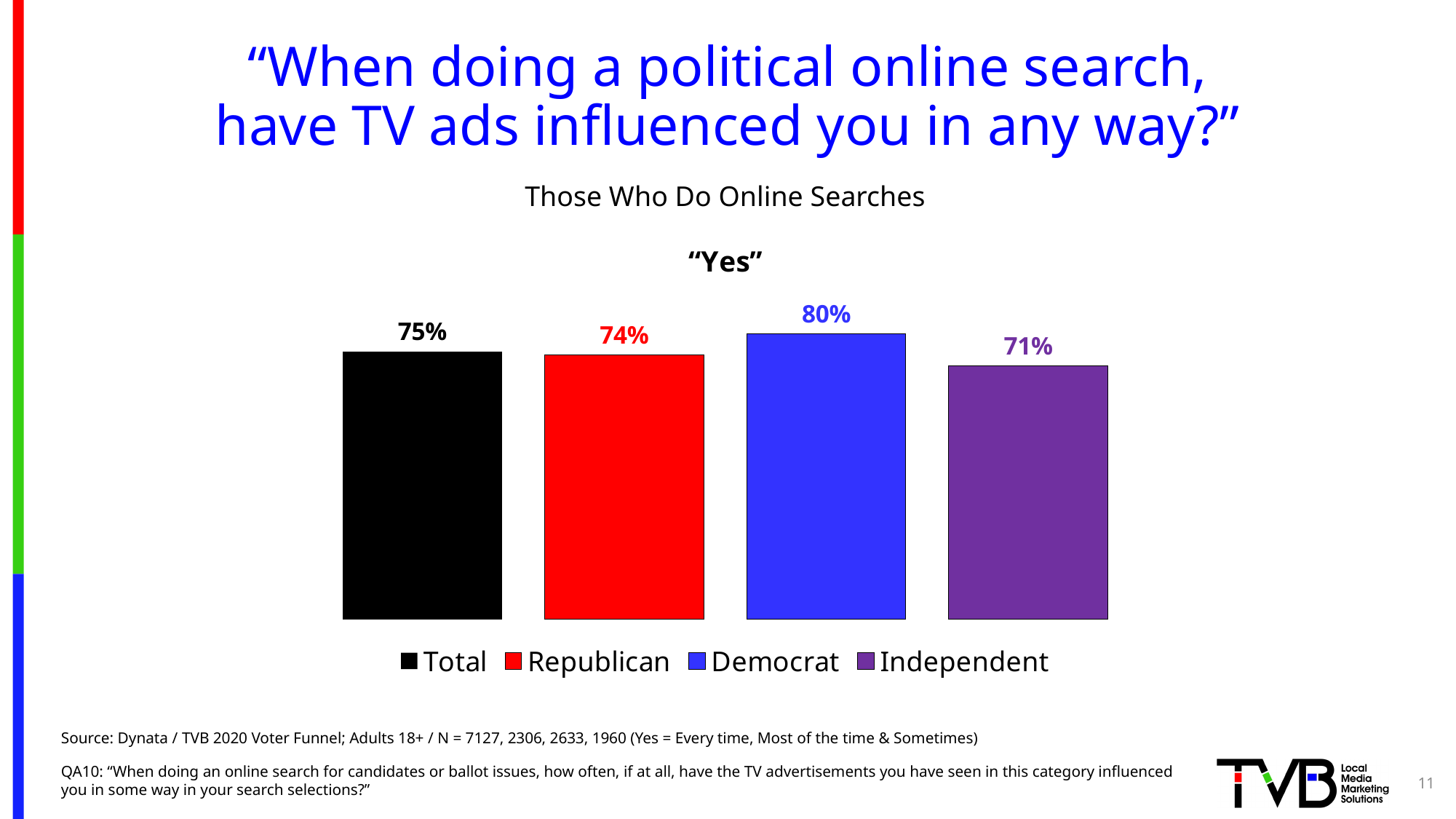
What is the value shown for Republican? 74% How many entries does the legend list? 4 Which group has the highest "Yes" percentage? Democrat Which group has the lowest "Yes" percentage? Independent What percentage of Democrats answered "Yes"? 80% How many bars are shown in the chart? 4 What is the difference between the Democrat and Independent values? 9% What is the value shown for Total? 75% What type of chart is shown on the slide? Bar chart What is the difference between the Total and Republican values? 1% Which is larger, the value for Democrat or the value for Republican? Democrat What is the value shown for Independent? 71%